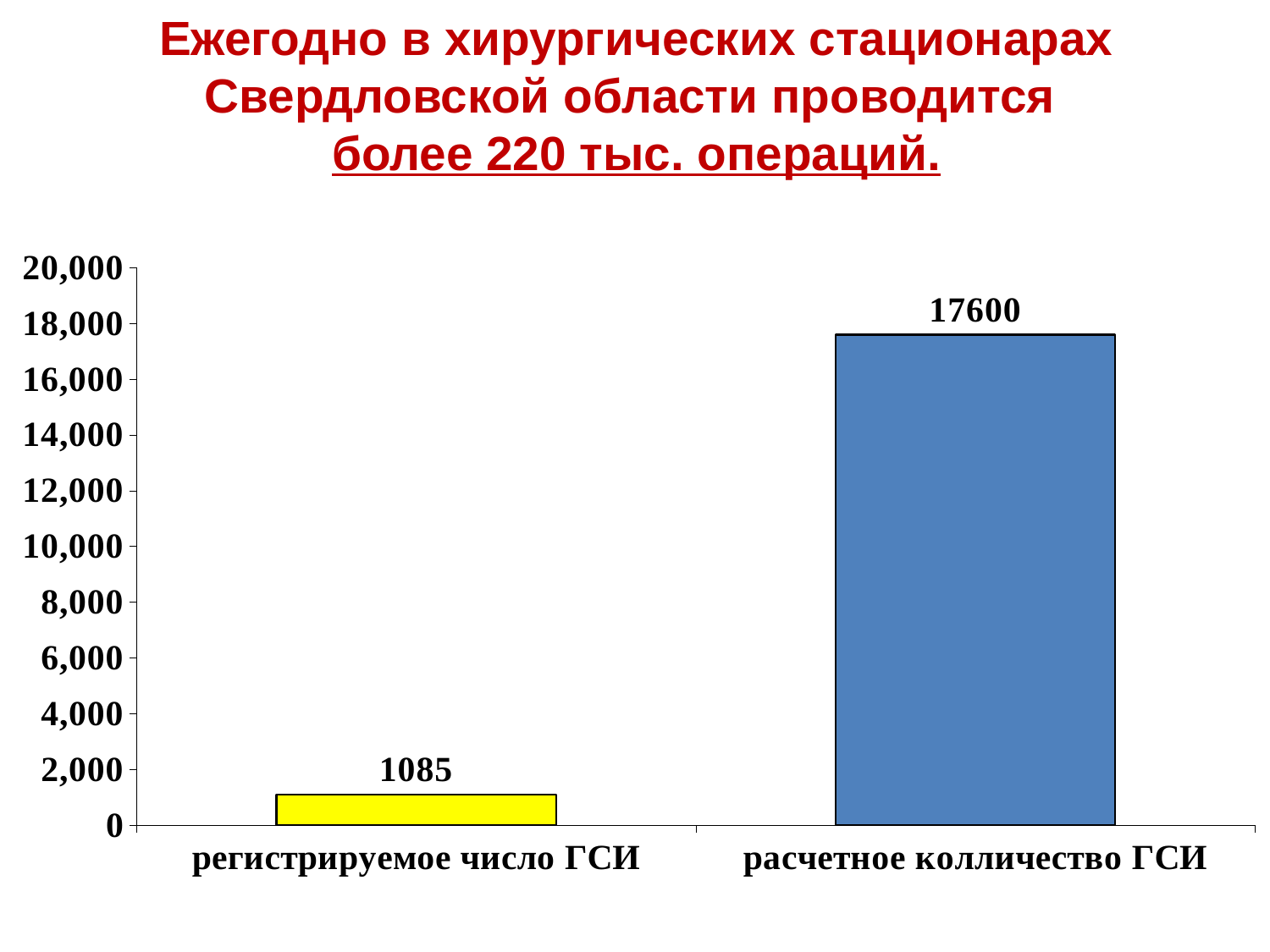
What is the maximum value shown on the vertical axis? 20,000 How many categories are shown in the chart? 2 Which category has the lowest value? регистрируемое число ГСИ What colour is the bar for регистрируемое число ГСИ? yellow Which is larger: регистрируемое число ГСИ or расчетное колличество ГСИ? расчетное колличество ГСИ Which category has the highest value? расчетное колличество ГСИ What is the value for расчетное колличество ГСИ? 17600 Is the value for регистрируемое число ГСИ greater or less than 2,000? less What is the value for регистрируемое число ГСИ? 1085 What kind of chart is shown on the slide? bar chart What is the difference between расчетное колличество ГСИ and регистрируемое число ГСИ? 16515 Is the value for расчетное колличество ГСИ greater or less than 16,000? greater